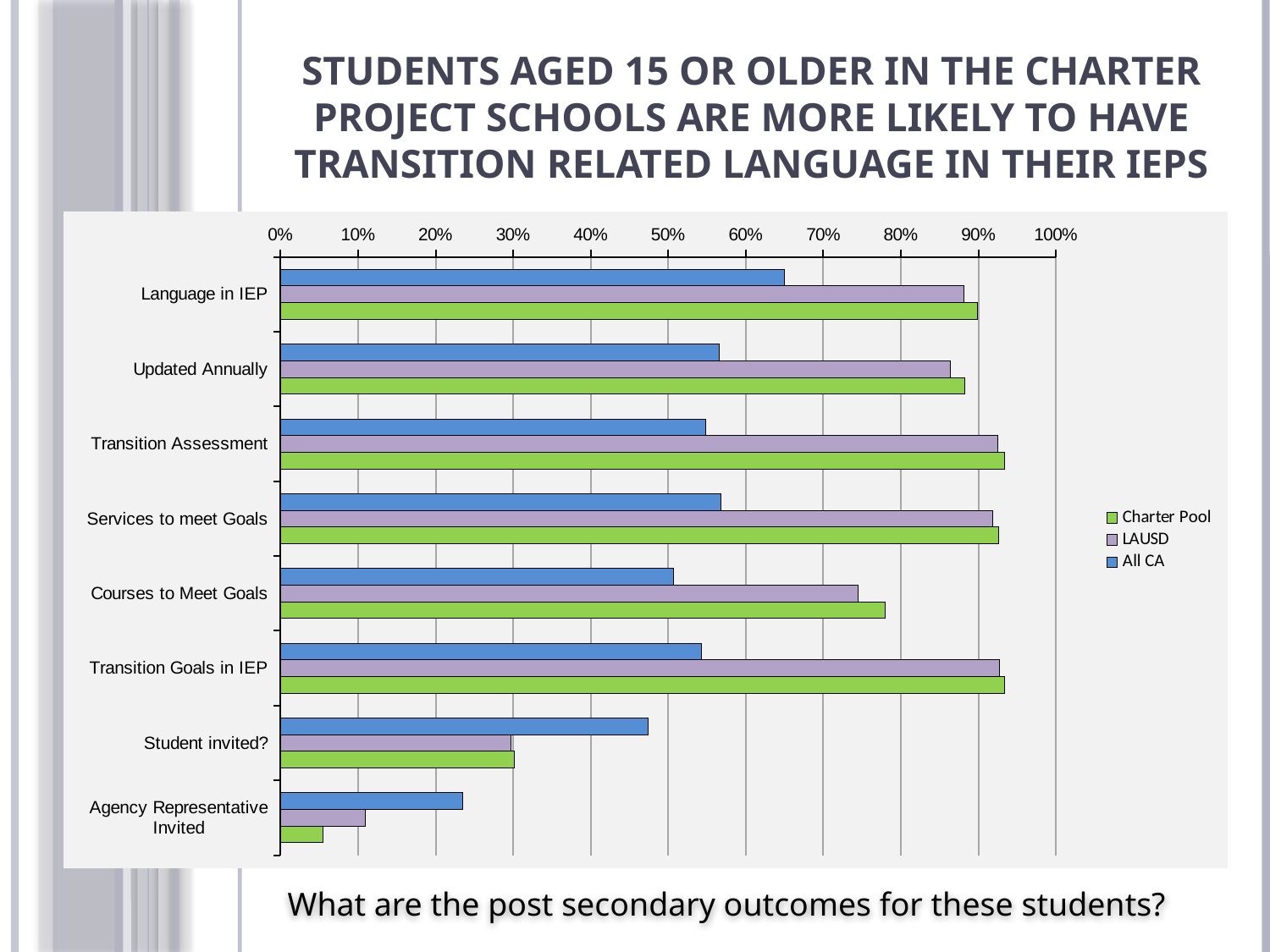
Which category has the lowest Charter Pool value? Agency Representative Invited Is the Charter Pool value for Agency Representative Invited greater or less than 10%? less For Agency Representative Invited, which series has the larger value, All CA or LAUSD? All CA Is the All CA value for Courses to Meet Goals greater or less than 60%? less What colour represents the Charter Pool series in the legend? green How many series does the legend list? 3 Is the All CA value for Language in IEP greater or less than 60%? greater What kind of chart is shown on the slide? bar chart How many categories are plotted on the chart? 8 For Courses to Meet Goals, which series has the larger value, Charter Pool or LAUSD? Charter Pool For Student invited?, which series has the larger value, All CA or Charter Pool? All CA